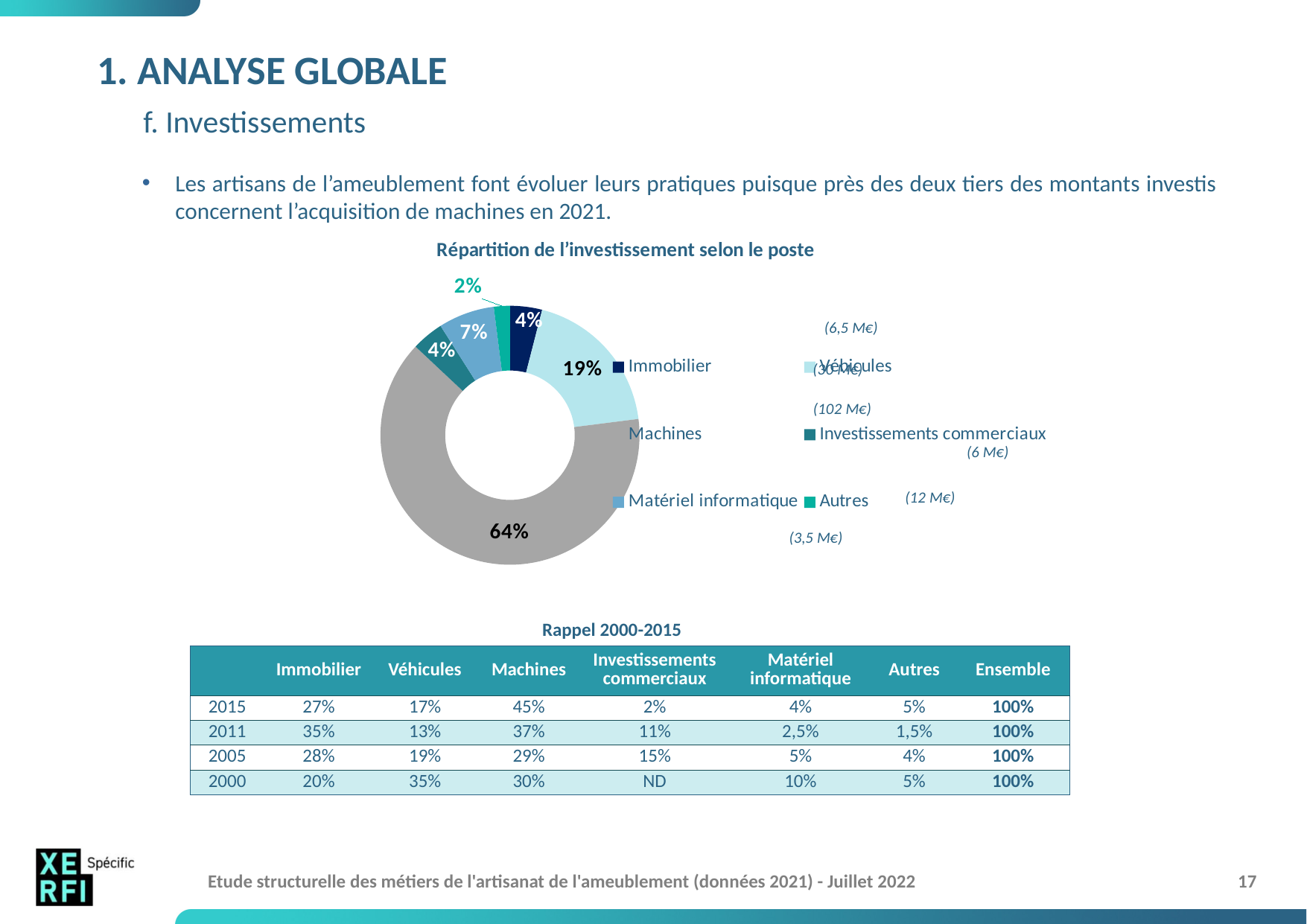
What share of investment does Véhicules account for in the donut chart? 19% What percentage is shown for Matériel informatique in the donut chart? 7% What is the title of the chart on the slide? Répartition de l'investissement selon le poste Which category has the largest share in the chart 'Répartition de l'investissement selon le poste'? Machines How many entries does the legend of the donut chart list? 6 Which category has the smallest share in the donut chart? Autres What type of chart is used to show 'Répartition de l'investissement selon le poste'? Donut (pie) chart In the donut chart, which is larger: the share for Véhicules or the share for Matériel informatique? Véhicules What share of investment does Machines account for in the chart 'Répartition de l'investissement selon le poste'? 64% In the donut chart, how many percentage points larger is the Machines share than the Véhicules share? 45 percentage points What percentage is shown for Autres in the donut chart? 2% How many categories are shown in the donut chart? 6